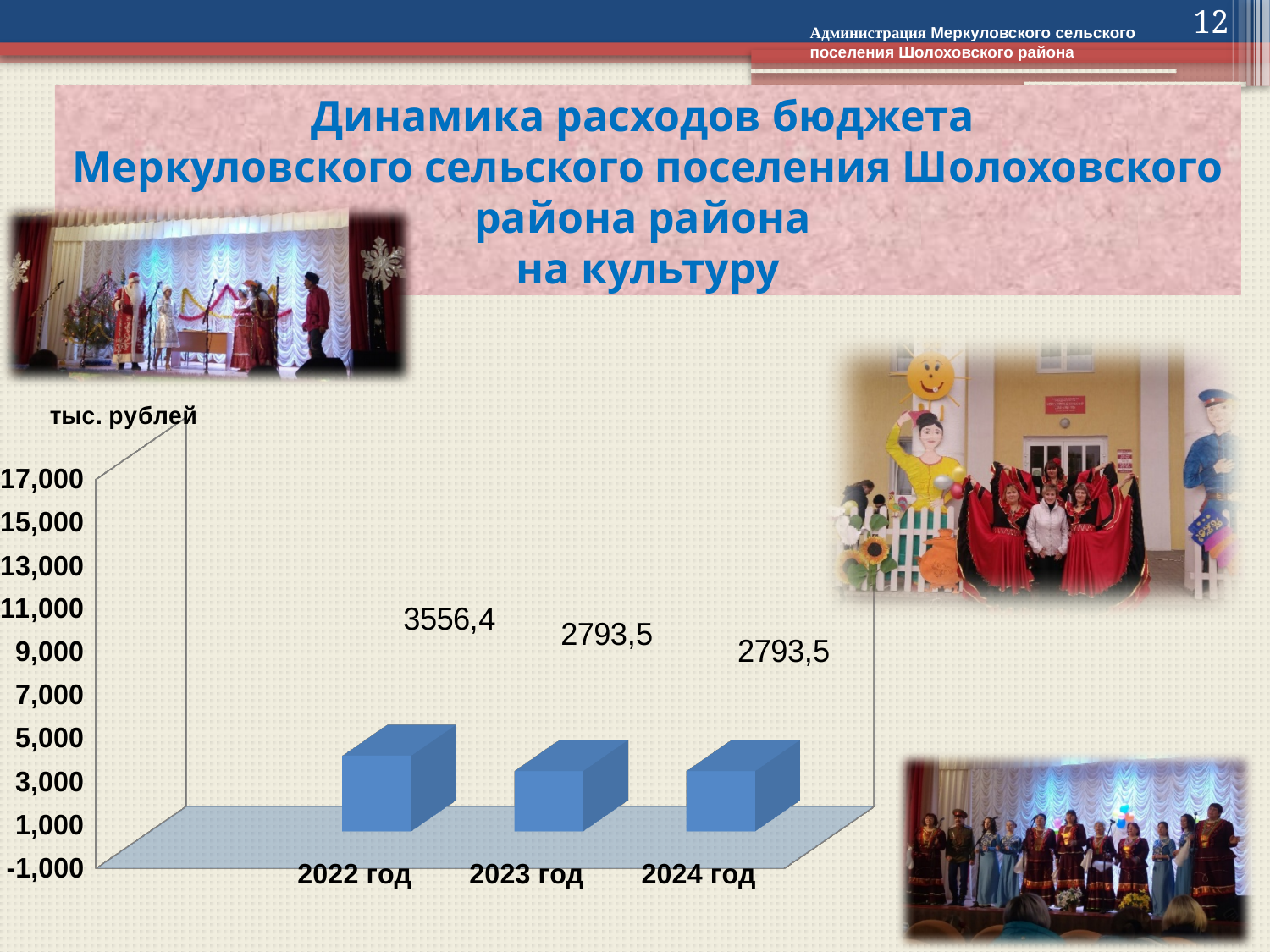
Which is larger, the value for 2022 год or the value for 2024 год? 2022 год Are the values for 2023 год and 2024 год the same or different? the same What is the value for 2023 год? 2793,5 How many years are shown on the chart? 3 What is the value for 2024 год? 2793,5 Do the values rise or fall from 2022 год to 2023 год? fall What is the difference between the values for 2022 год and 2023 год? 762,9 Which year has the highest value? 2022 год What kind of chart is shown on the slide? bar chart What unit is shown on the vertical axis label of the chart? тыс. рублей What is the value for 2022 год? 3556,4